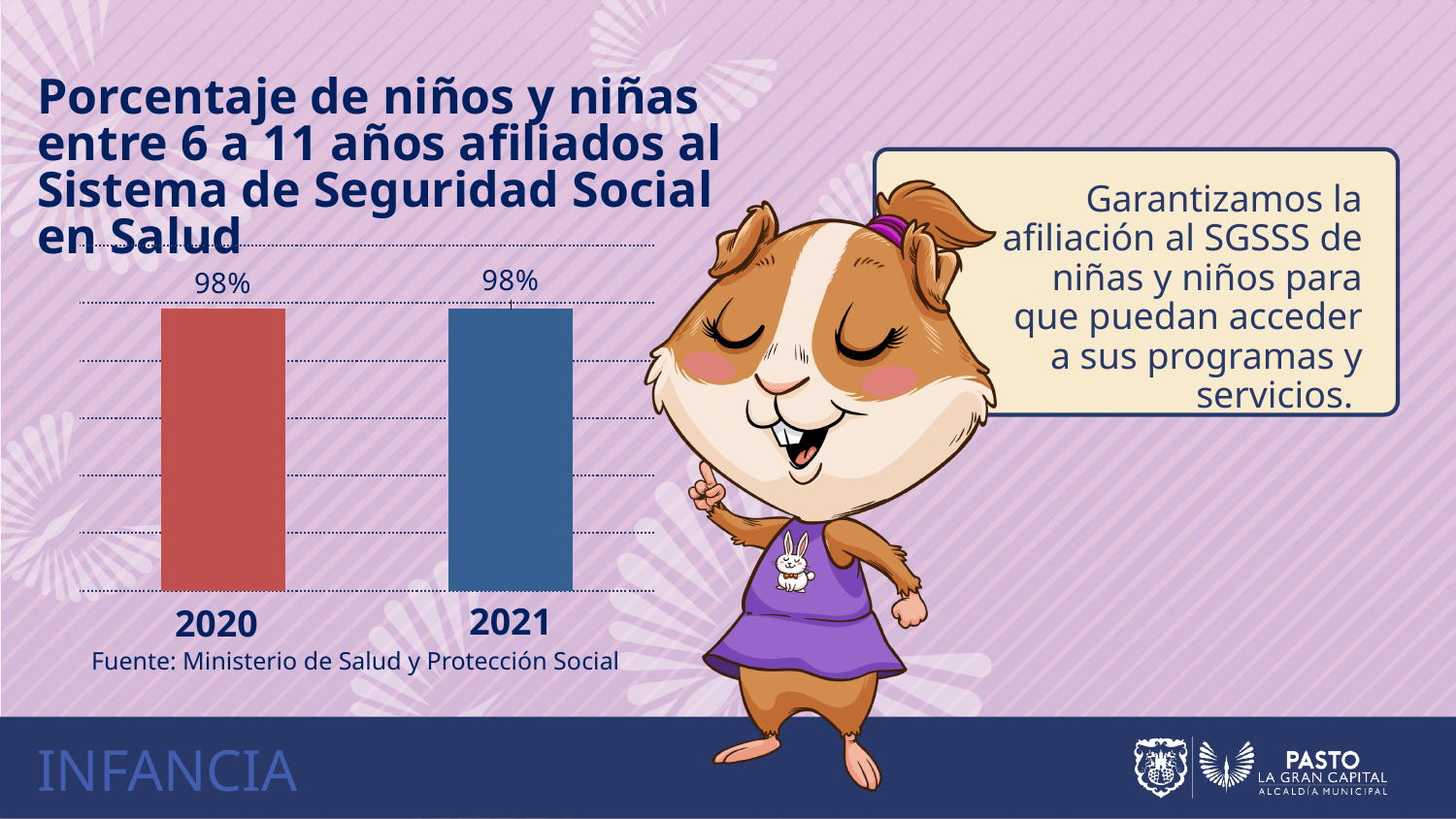
What is the value for 2021? 98% What is the difference between the values for 2020 and 2021? 0% Do the values rise, fall or stay the same from 2020 to 2021? Stay the same Which years are shown on the x axis of the chart? 2020 and 2021 What is the value for 2020? 98% What kind of chart is shown on the slide? Bar chart Is the value for 2021 greater or less than 50%? greater How many categories (years) are shown in the chart? 2 What source is cited below the chart? Ministerio de Salud y Protección Social